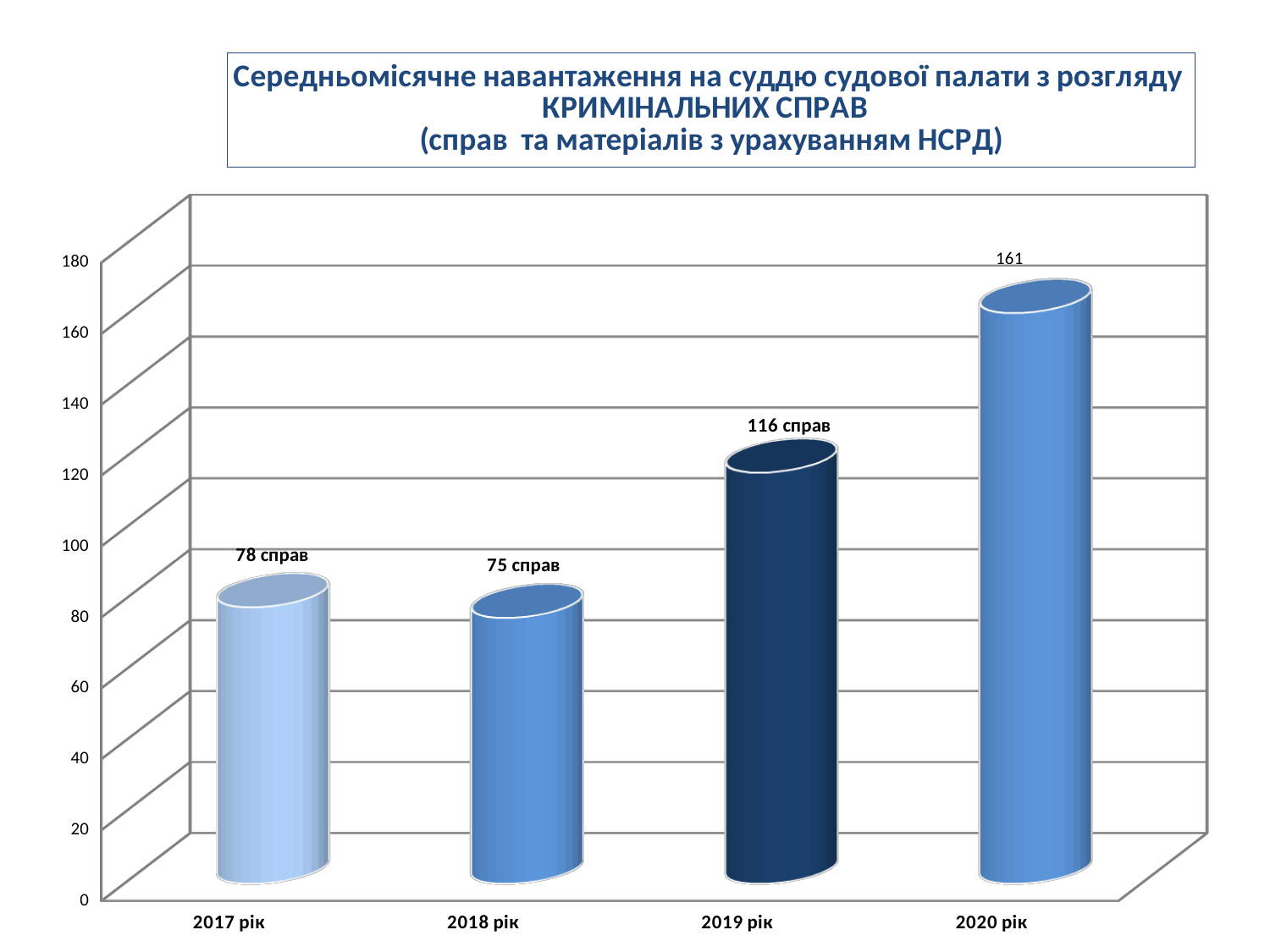
What is the value shown for 2019 рік? 116 справ What is the value shown for 2017 рік? 78 справ What is the value shown for 2018 рік? 75 справ Which year has the lowest value? 2018 рік What is the difference between the values for 2017 рік and 2018 рік? 3 What kind of chart is shown on the slide? bar chart Which is larger, the value for 2019 рік or the value for 2017 рік? 2019 рік What is the difference between the values for 2020 рік and 2019 рік? 45 How many years are shown on the x axis? 4 Which year has the highest value? 2020 рік Does the value rise or fall from 2018 рік to 2020 рік? rise What is the value shown for 2020 рік? 161